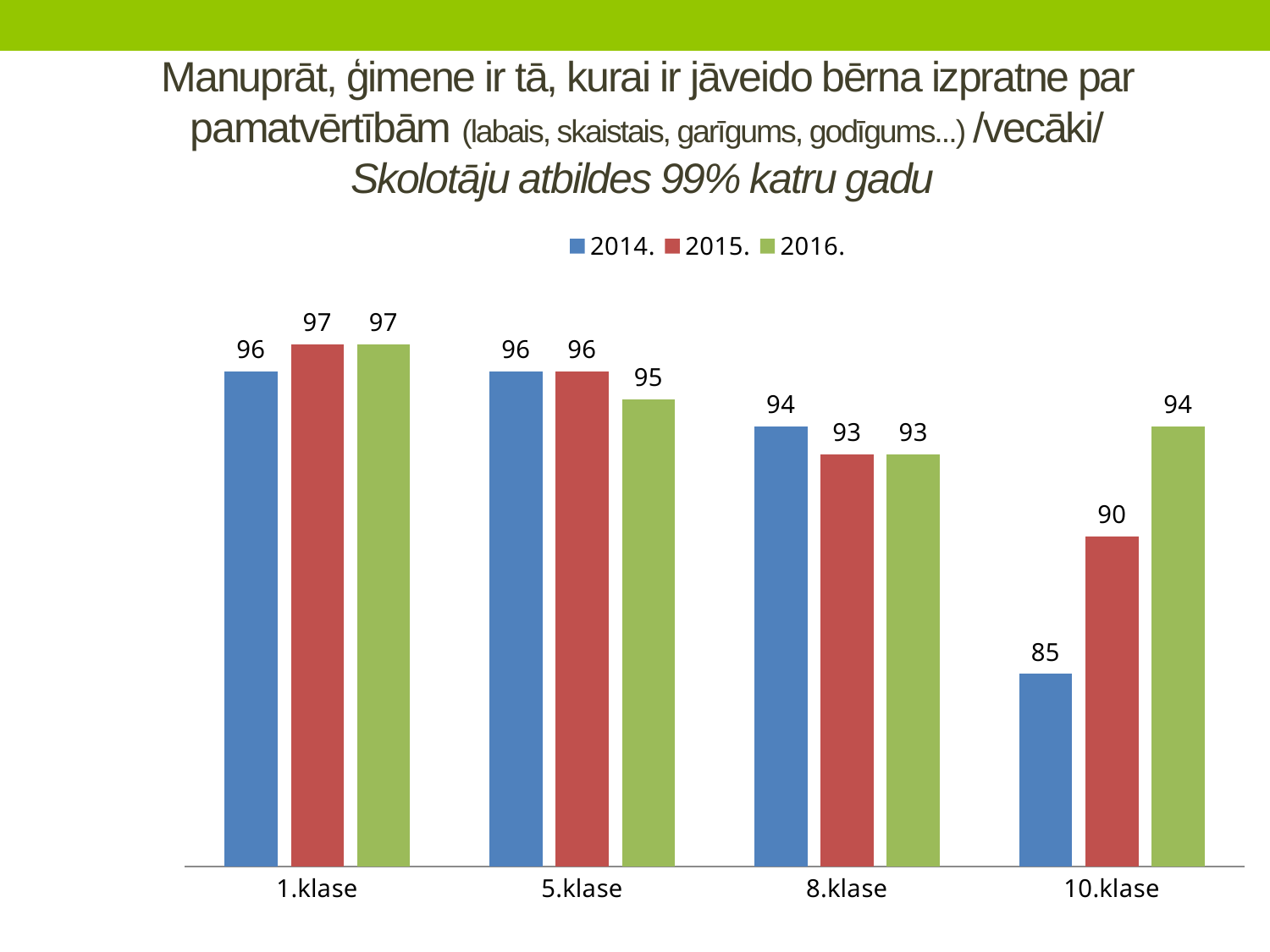
How many categories are shown on the x axis? 4 Do the 2014. values rise or fall from 1.klase to 10.klase? fall What is the value for 2015. in 8.klase? 93 How many series does the legend list? 3 What is the value for 2016. in 5.klase? 95 Which is larger in 8.klase: the 2014. value or the 2015. value? 2014. Which category has the highest value for 2015.? 1.klase What kind of chart is shown on the slide? bar chart What is the difference between the 2016. and 2014. values in 10.klase? 9 Which category has the lowest value for 2014.? 10.klase What is the value for 2014. in 10.klase? 85 Which colour represents the 2016. series in the legend? green